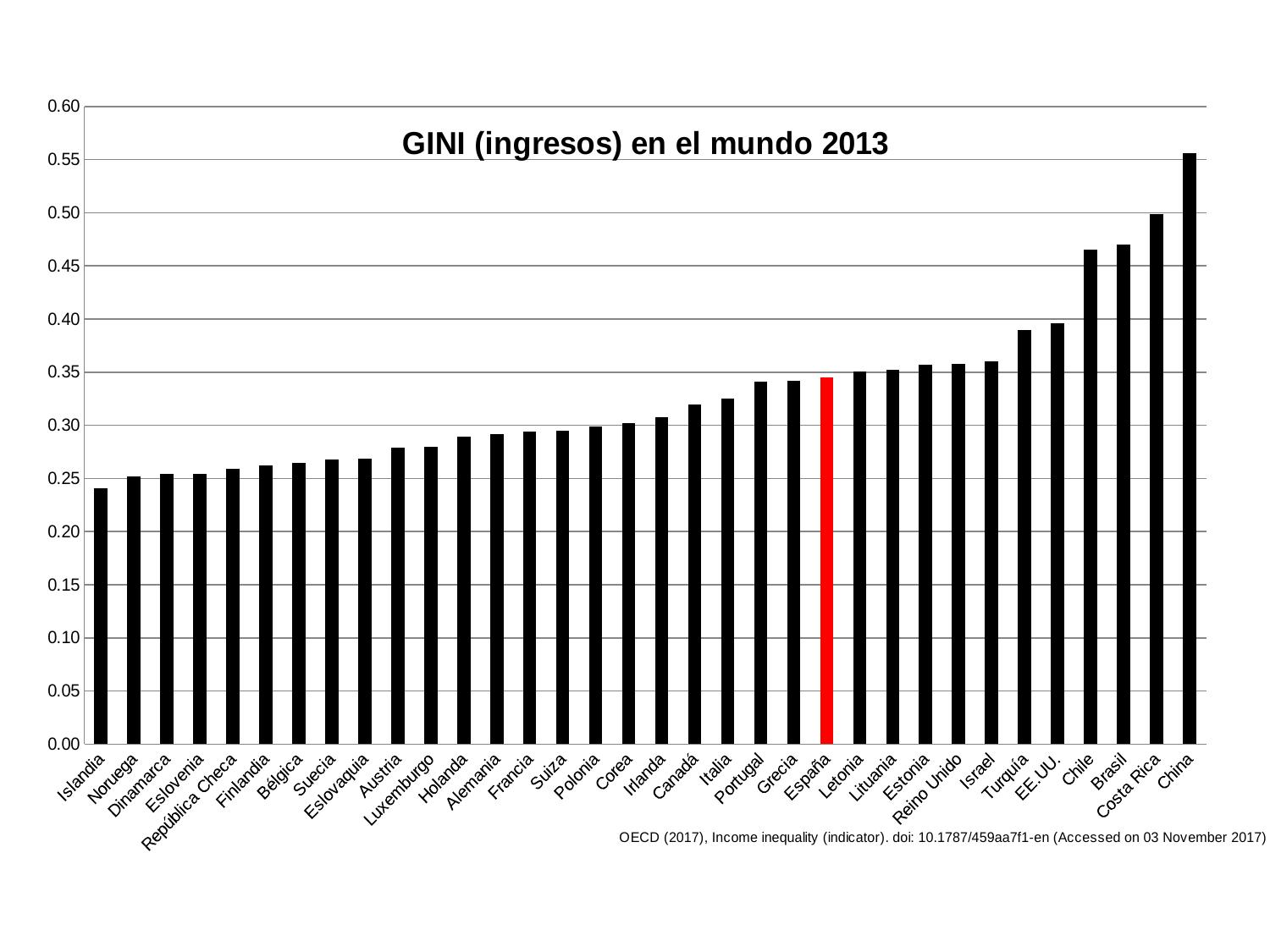
Which country has the highest GINI value in the chart? China Do the values rise or fall from left to right along the x axis? rise Which country has the lowest GINI value in the chart? Islandia Which country's bar is highlighted in red? España How many countries are shown in the chart? 34 Which has the larger value, Costa Rica or Chile? Costa Rica Is the value for Turquía greater or less than 0.40? less What kind of chart is shown on the slide? bar chart Is the value for China greater or less than 0.50? greater What is the title of the chart? GINI (ingresos) en el mundo 2013 Is the value for España greater or less than 0.30? greater